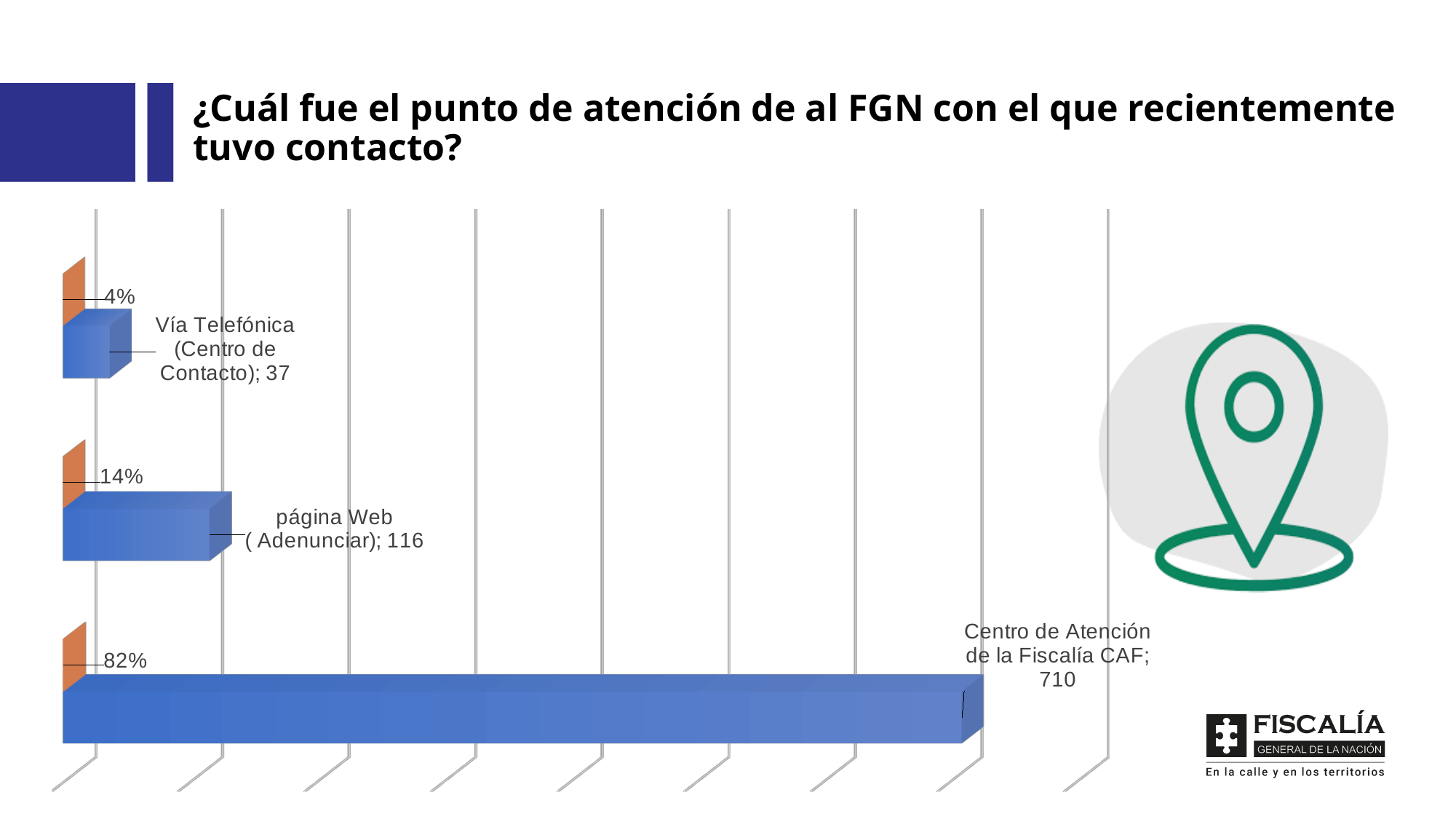
What percentage is shown for Centro de Atención de la Fiscalía CAF? 82% Which has a larger count, página Web (Adenunciar) or Vía Telefónica (Centro de Contacto)? página Web (Adenunciar) What is the count value for Centro de Atención de la Fiscalía CAF? 710 What percentage is shown for página Web (Adenunciar)? 14% What is the difference between the counts for Centro de Atención de la Fiscalía CAF and página Web (Adenunciar)? 594 What percentage is shown for Vía Telefónica (Centro de Contacto)? 4% Which point of contact has the highest count? Centro de Atención de la Fiscalía CAF What is the count value for página Web (Adenunciar)? 116 What is the count value for Vía Telefónica (Centro de Contacto)? 37 What kind of chart is shown on the slide? Bar chart Which point of contact has the lowest count? Vía Telefónica (Centro de Contacto) How many points of contact are shown in the chart? 3